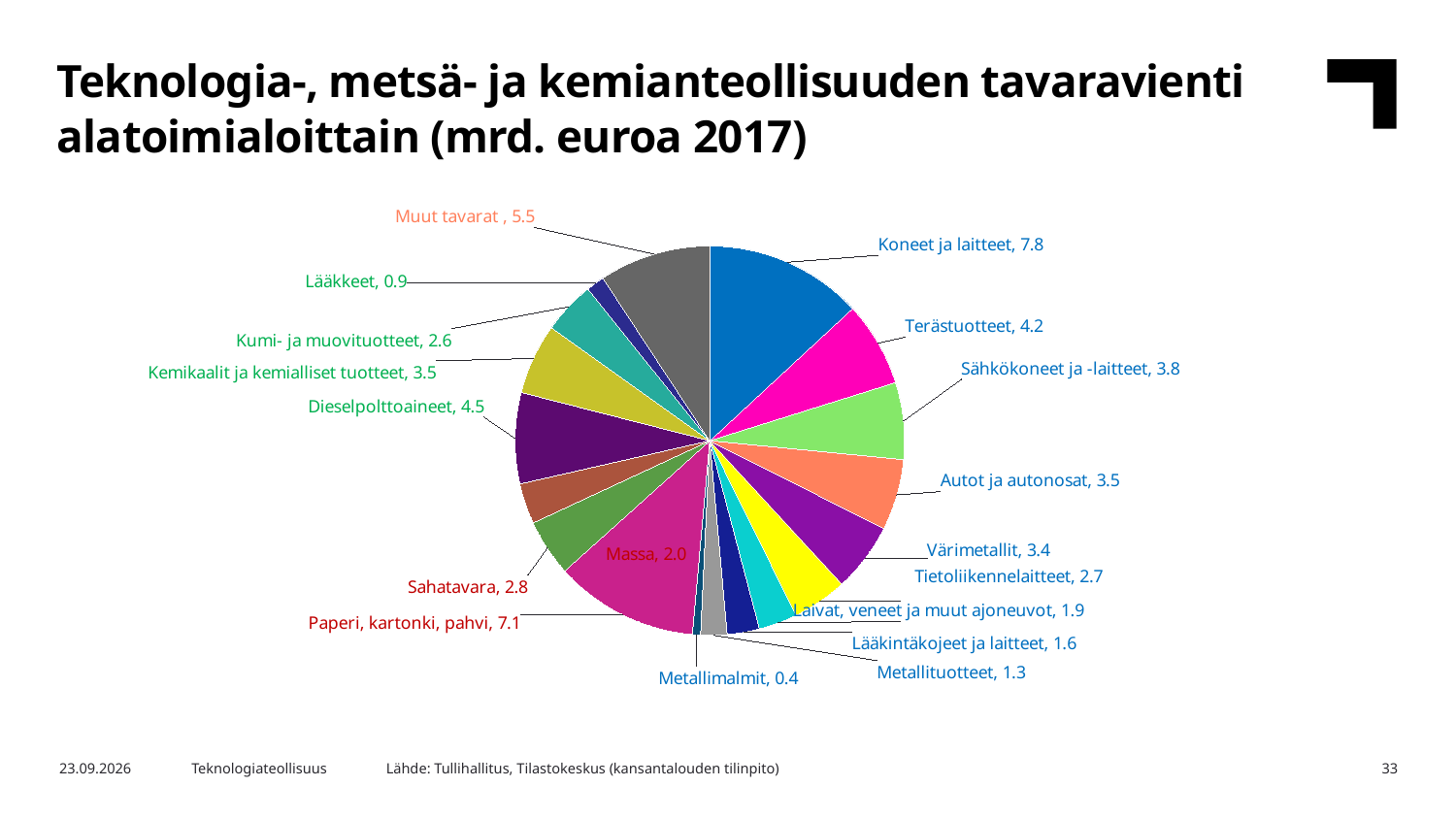
What is the difference between the values for Koneet ja laitteet and Paperi, kartonki, pahvi? 0.7 What is the value for Koneet ja laitteet? 7.8 What is the value for Paperi, kartonki, pahvi? 7.1 What is the value for Metallimalmit? 0.4 What is the value for Dieselpolttoaineet? 4.5 What type of chart is shown on the slide? Pie chart What is the difference between the values for Muut tavarat and Sahatavara? 2.7 Which is larger, Terästuotteet or Dieselpolttoaineet? Dieselpolttoaineet Which category has the largest slice in the pie chart? Koneet ja laitteet Which category has the smallest slice in the pie chart? Metallimalmit What is the title of the chart on the slide? Teknologia-, metsä- ja kemianteollisuuden tavaravienti alatoimialoittain (mrd. euroa 2017) How many slices does the pie chart have? 18